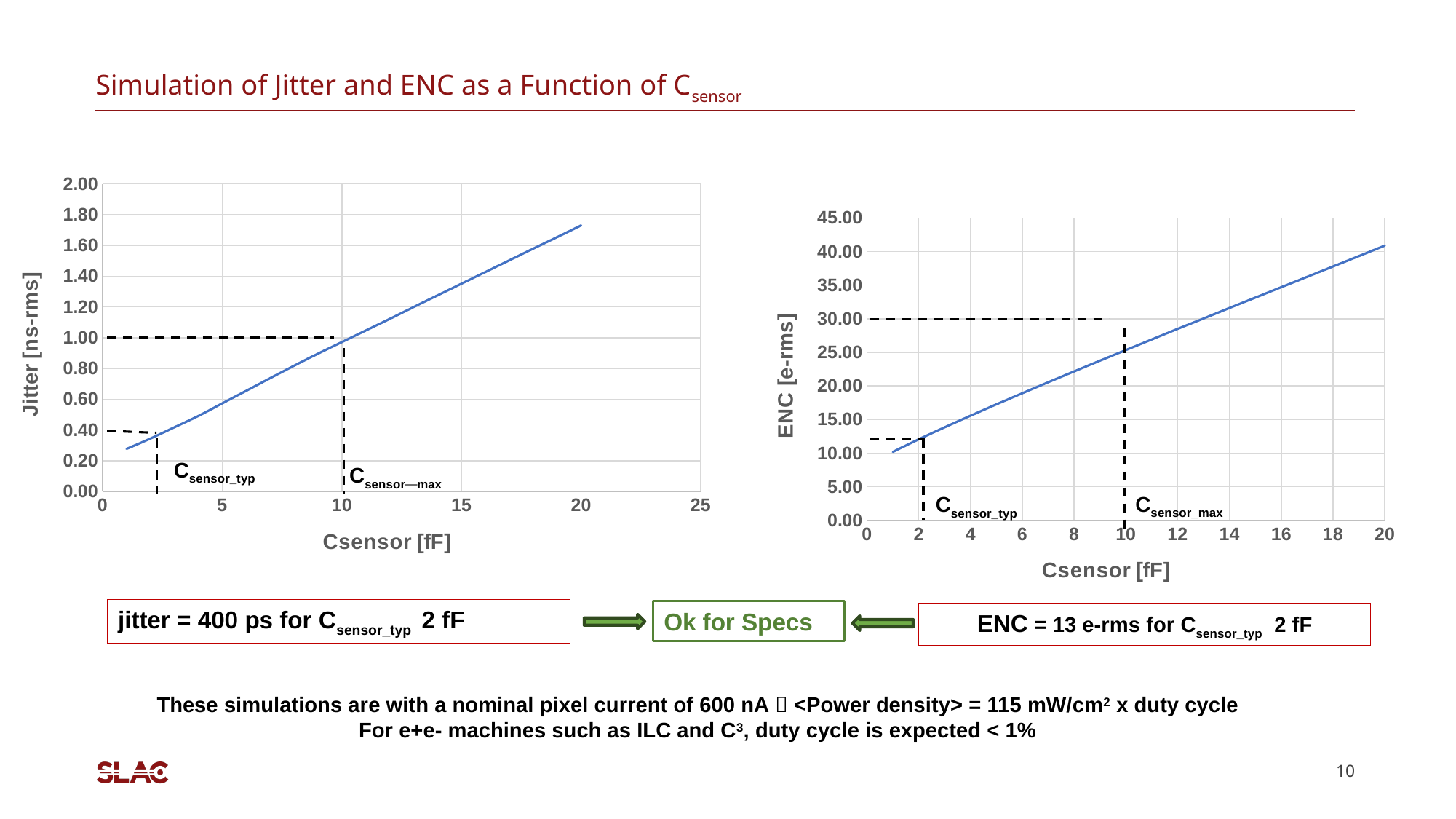
In the right chart, does ENC rise or fall as Csensor increases? rise In the left chart, is the jitter at Csensor = 20 fF greater or less than 1.60 ns-rms? greater What is the y-axis label of the right chart? ENC [e-rms] What kind of chart is the left chart (Jitter vs Csensor)? line chart In the left chart, does jitter rise or fall as Csensor increases? rise In the left chart, is the jitter at Csensor = 15 fF greater or less than 1.20 ns-rms? greater In the left chart, is the jitter at Csensor = 5 fF greater or less than 0.80 ns-rms? less What is the y-axis label of the left chart? Jitter [ns-rms] What kind of chart is the right chart (ENC vs Csensor)? line chart